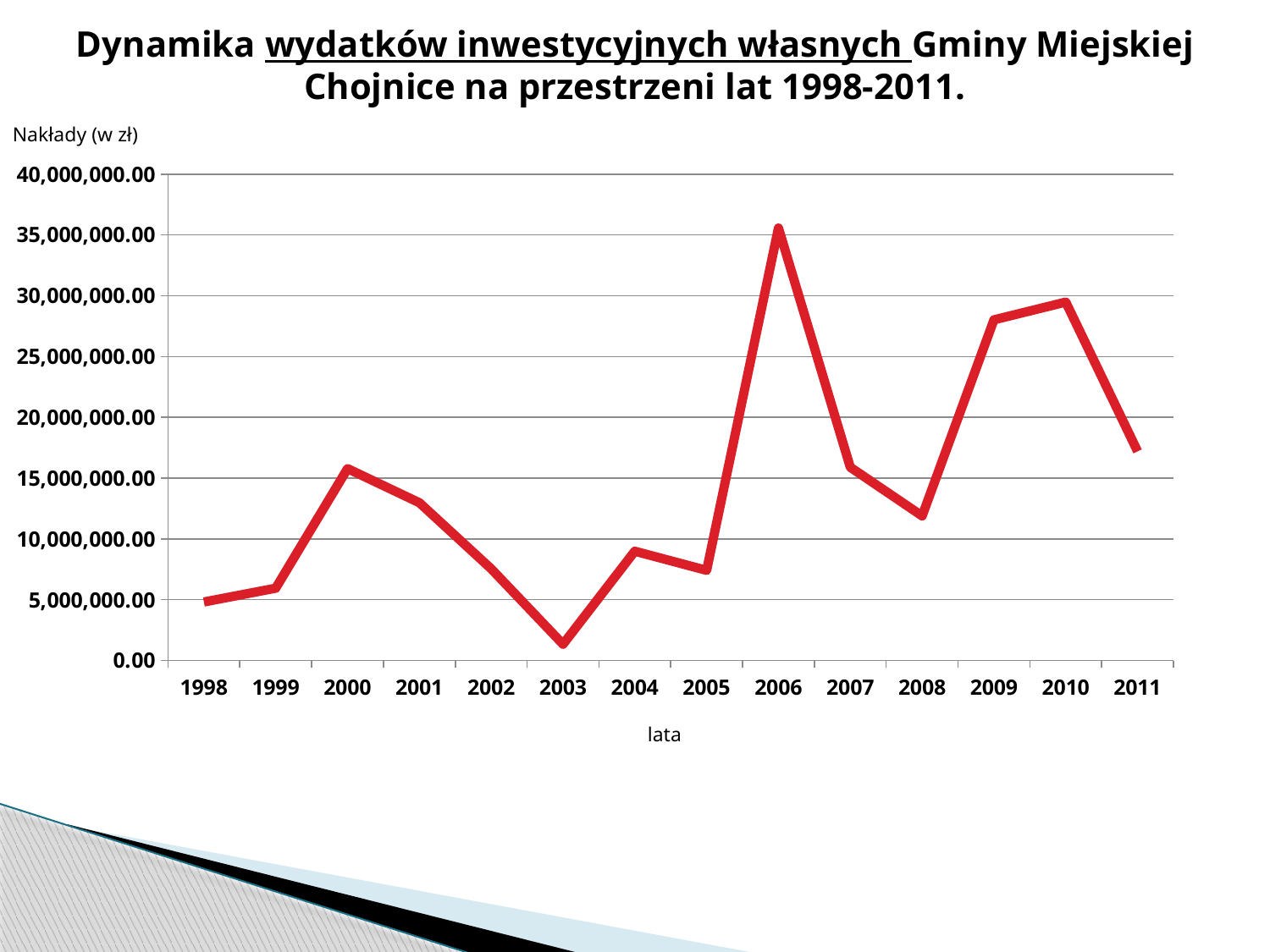
Do the values rise or fall from 2005 to 2006? rise Which year has the lowest value of investment expenditure? 2003 Is the value for 2003 greater or less than 5,000,000.00? less Is the value for 1998 greater or less than 10,000,000.00? less Is the value for 2006 greater or less than 30,000,000.00? greater Which year has the highest value of investment expenditure? 2006 How many years are plotted along the x axis? 14 What is the label of the vertical axis? Nakłady (w zł) What kind of chart is shown on the slide? line chart Do the values rise or fall from 2010 to 2011? fall Which year has the larger value, 2009 or 2011? 2009